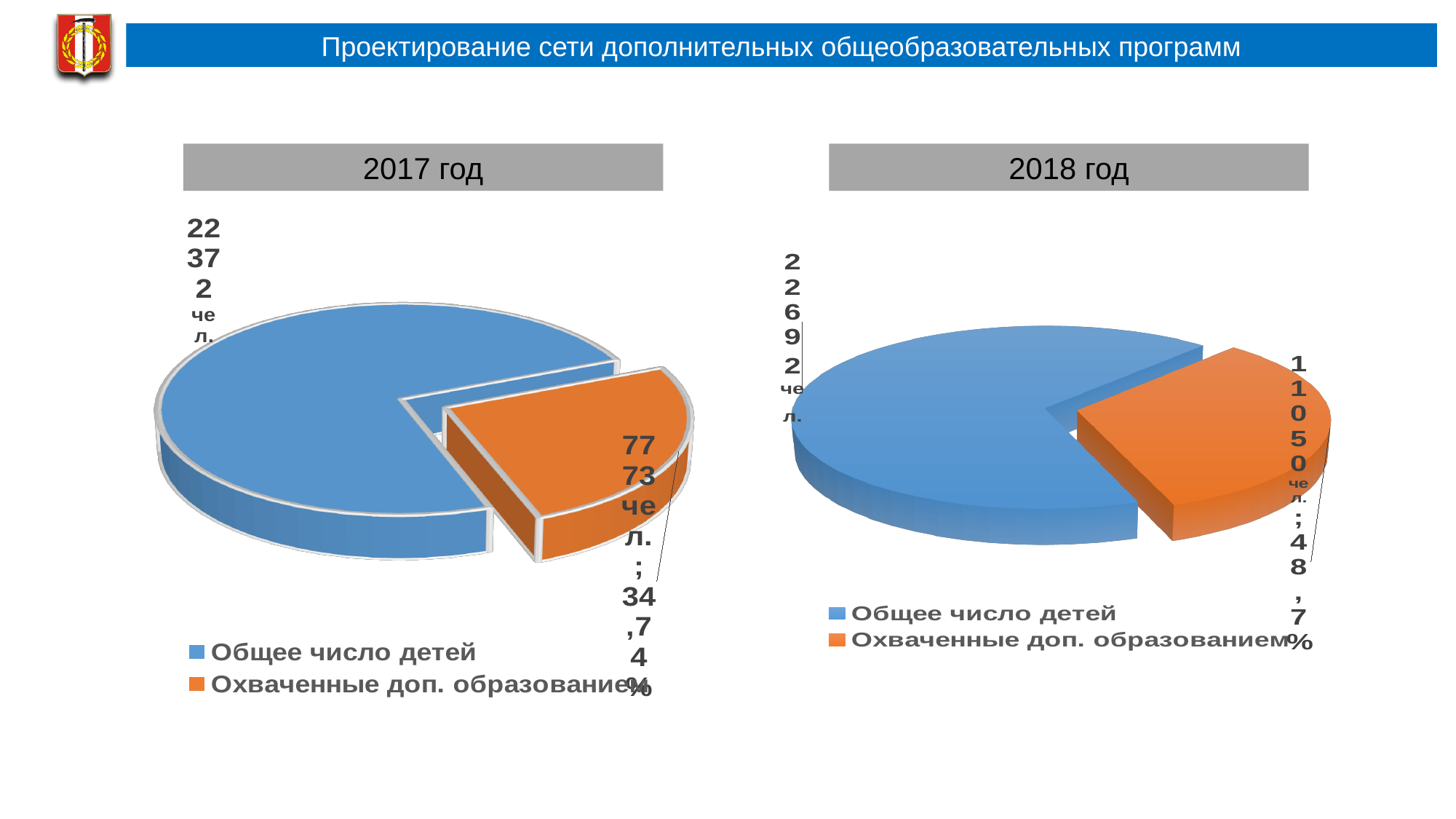
How many entries does the legend of the 2017 год chart list? 2 In the 2018 год chart, what share of the pie does Охваченные доп. образованием take? 48,7% What kind of chart is used on the slide for 2017 год and 2018 год? Pie chart What is the difference between the Охваченные доп. образованием value in the 2018 год chart and in the 2017 год chart? 3277 чел. In the 2017 год chart, what is the value for Общее число детей? 22372 чел. In the 2018 год chart, what is the value for Общее число детей? 22692 чел. In the 2017 год chart, which slice is the largest? Общее число детей Which is larger: the value for Охваченные доп. образованием in the 2017 год chart or in the 2018 год chart? 2018 год In the 2018 год chart, what is the value for Охваченные доп. образованием? 11050 чел. How many slices does the 2018 год pie chart have? 2 In the 2017 год chart, what is the value for Охваченные доп. образованием? 7773 чел. In the 2017 год chart, what share of the pie does Охваченные доп. образованием take? 34,74%